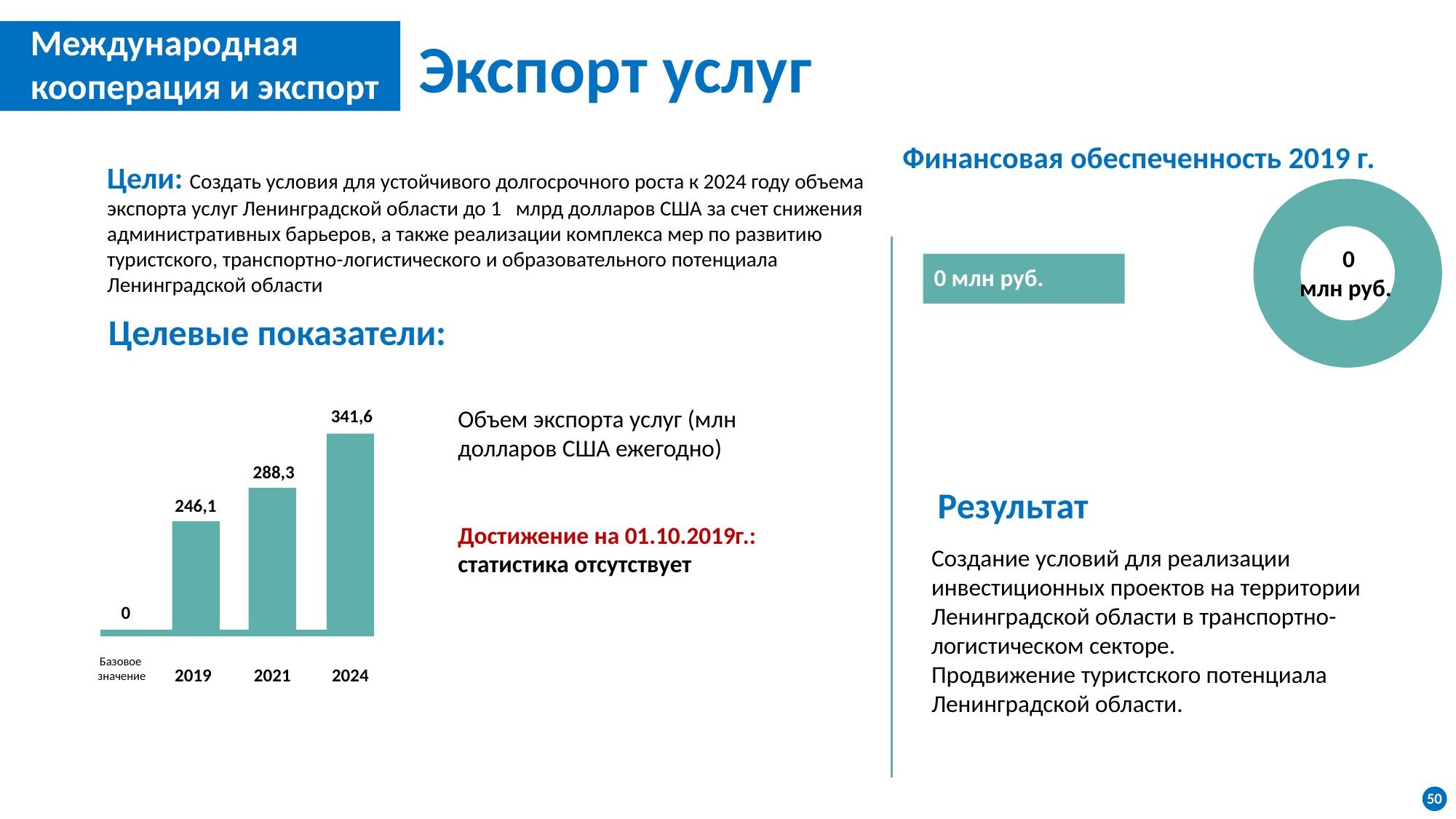
In the bar chart 'Объем экспорта услуг (млн долларов США ежегодно)', what is the value for 'Базовое значение'? 0 How many categories are shown in the bar chart 'Объем экспорта услуг (млн долларов США ежегодно)'? 4 In the bar chart 'Объем экспорта услуг (млн долларов США ежегодно)', what is the difference between the values for 2024 and 2021? 53,3 In the bar chart 'Объем экспорта услуг (млн долларов США ежегодно)', do the values rise or fall from 'Базовое значение' to 2024? rise In the bar chart 'Объем экспорта услуг (млн долларов США ежегодно)', what is the value for 2024? 341,6 In the bar chart 'Объем экспорта услуг (млн долларов США ежегодно)', what is the value for 2019? 246,1 In the bar chart 'Объем экспорта услуг (млн долларов США ежегодно)', what is the value for 2021? 288,3 In the bar chart 'Объем экспорта услуг (млн долларов США ежегодно)', which category has the lowest value? Базовое значение In the bar chart 'Объем экспорта услуг (млн долларов США ежегодно)', what is the difference between the values for 2021 and 2019? 42,2 What kind of chart is used for 'Объем экспорта услуг (млн долларов США ежегодно)'? bar chart In the bar chart 'Объем экспорта услуг (млн долларов США ежегодно)', which is larger, the value for 2019 or the value for 2021? 2021 In the bar chart 'Объем экспорта услуг (млн долларов США ежегодно)', which category has the highest value? 2024